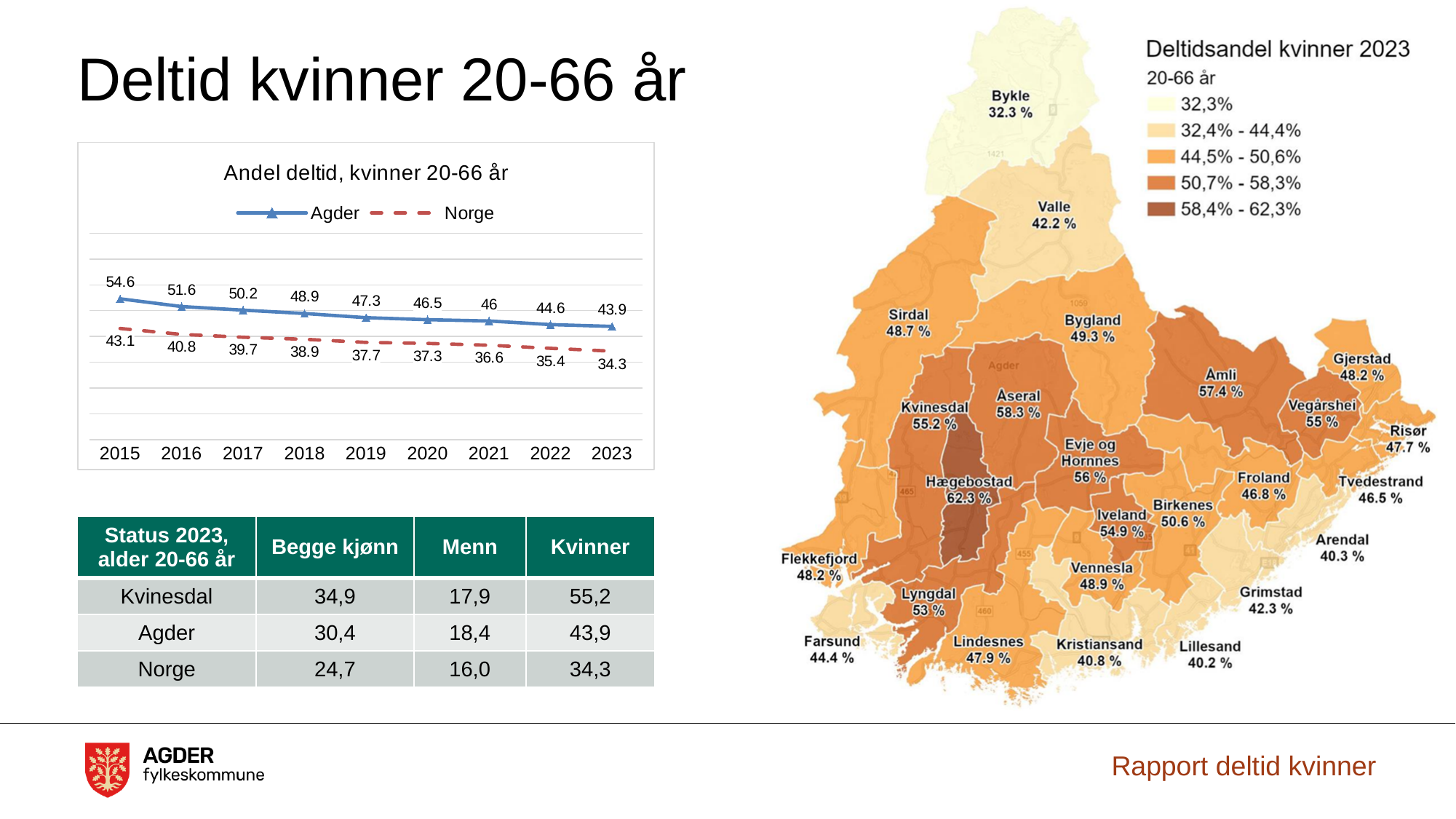
In the chart 'Andel deltid, kvinner 20-66 år', what is the value for Agder in 2015? 54.6 How many series does the legend of the chart 'Andel deltid, kvinner 20-66 år' list? 2 In the chart 'Andel deltid, kvinner 20-66 år', which year has the highest value for Agder? 2015 In the chart 'Andel deltid, kvinner 20-66 år', what is the difference between the Agder value in 2015 and in 2023? 10.7 In the chart 'Andel deltid, kvinner 20-66 år', what is the difference between Agder and Norge in 2023? 9.6 In the chart 'Andel deltid, kvinner 20-66 år', what is the value for Norge in 2023? 34.3 In the chart 'Andel deltid, kvinner 20-66 år', what is the value for Agder in 2020? 46.5 In the chart 'Andel deltid, kvinner 20-66 år', what is the value for Norge in 2018? 38.9 In the chart 'Andel deltid, kvinner 20-66 år', which year has the lowest value for Norge? 2023 What type of chart is 'Andel deltid, kvinner 20-66 år'? line chart How many years are shown on the x axis of the chart 'Andel deltid, kvinner 20-66 år'? 9 In the chart 'Andel deltid, kvinner 20-66 år', which is larger in 2019: Agder or Norge? Agder